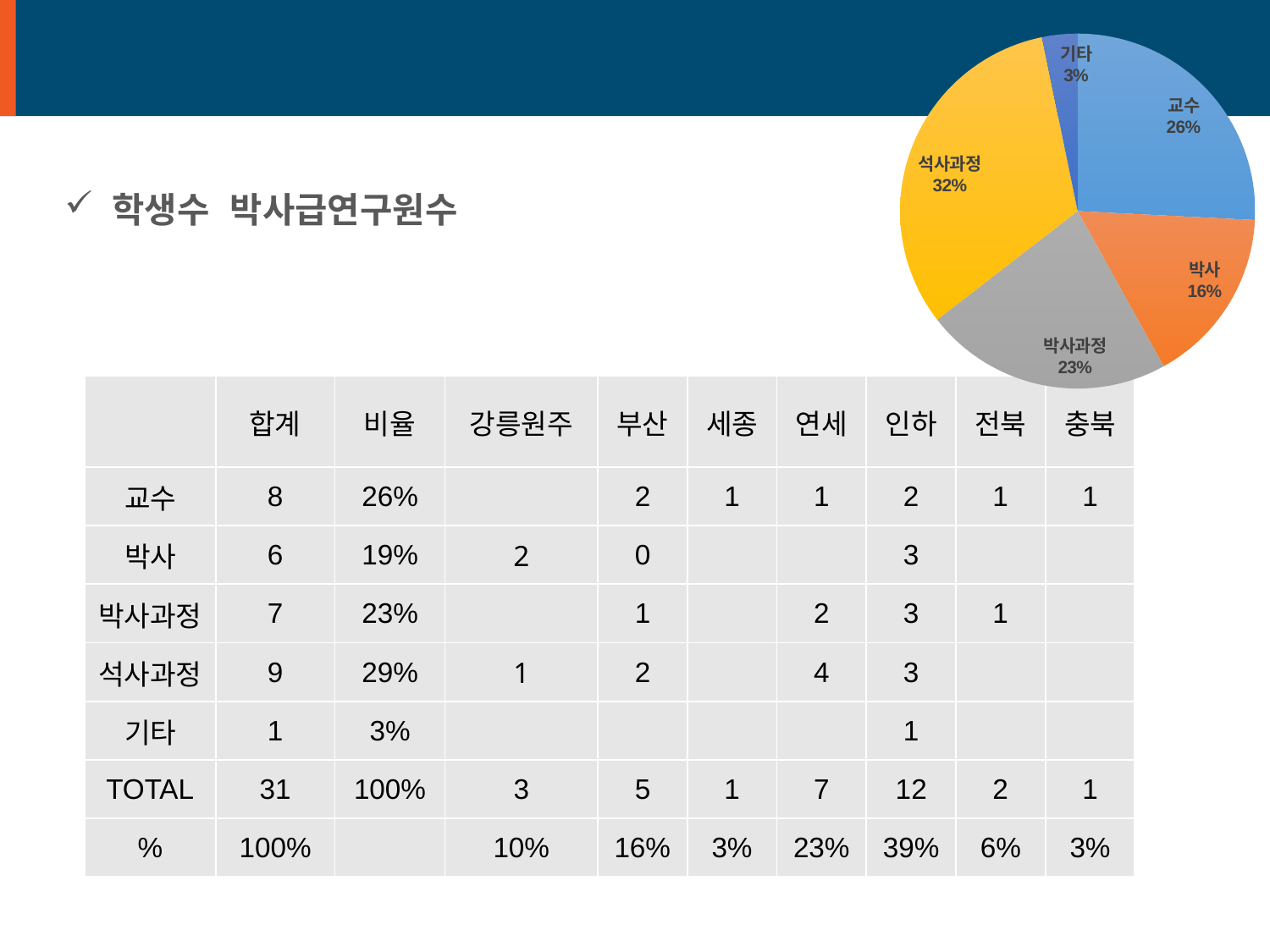
In the pie chart, which is larger, 교수 or 박사과정? 교수 In the pie chart, what is the difference in percentage points between 석사과정 and 박사? 16% What share of the pie chart does 박사과정 represent? 23% What share of the pie chart does 석사과정 represent? 32% What share of the pie chart does 기타 represent? 3% Which slice of the pie chart is the largest? 석사과정 What kind of chart is shown on the slide? pie chart How many slices does the pie chart have? 5 Which slice of the pie chart is the smallest? 기타 What colour is the 석사과정 slice in the pie chart? yellow